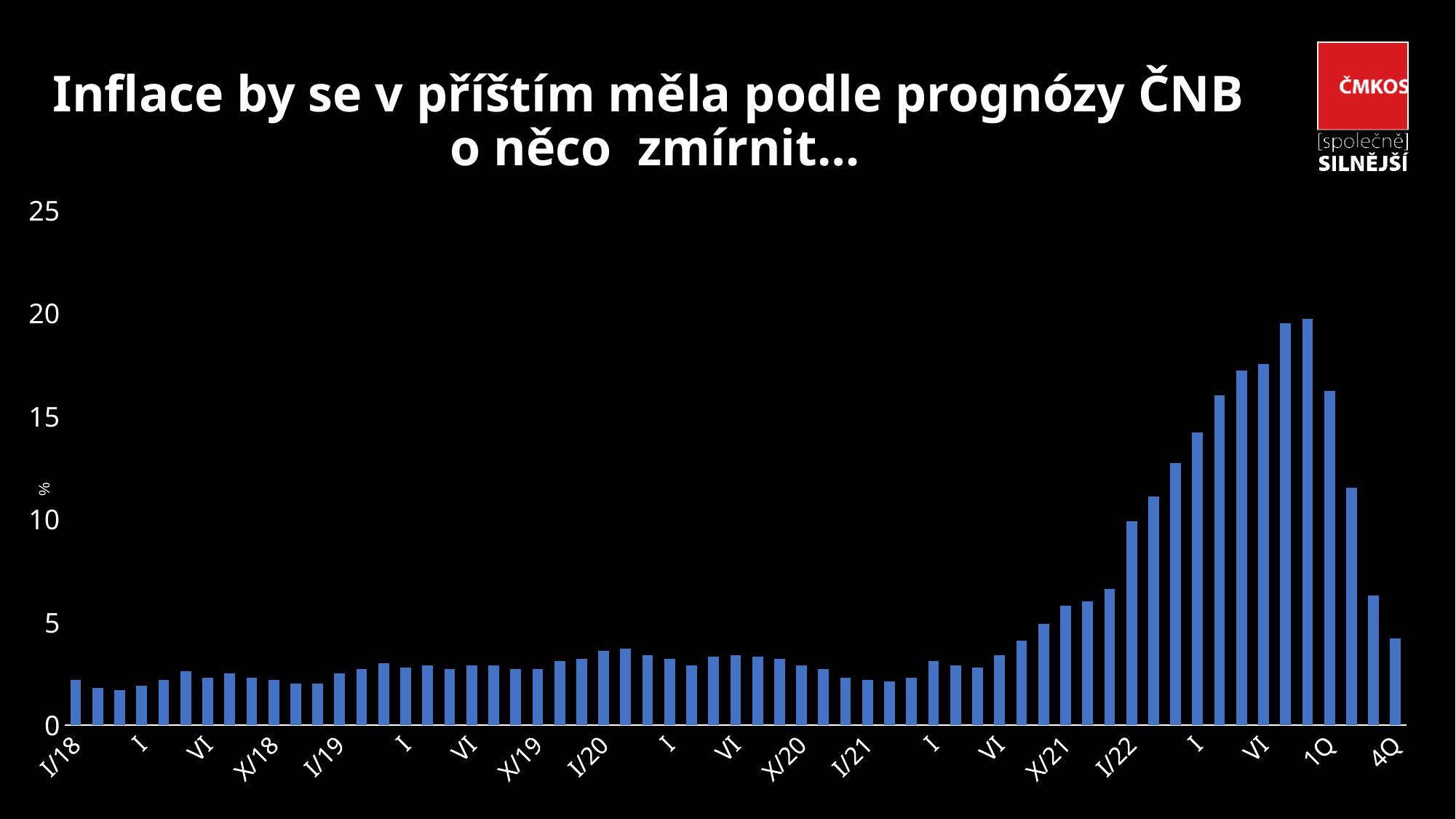
Do the values rise or fall from 1Q to 4Q? fall What unit is shown on the y axis? % Is the value for I/21 greater or less than 5? less Which is larger, the value for 1Q or the value for 4Q? 1Q Is the value for 1Q greater or less than 10? greater Do the values rise or fall from I/21 to 1Q? rise Is the highest bar in the chart greater or less than 15? greater What is the title of the slide? Inflace by se v příštím měla podle prognózy ČNB o něco zmírnit… What kind of chart is shown on the slide? bar chart Which is larger, the value for I/18 or the value for 4Q? 4Q